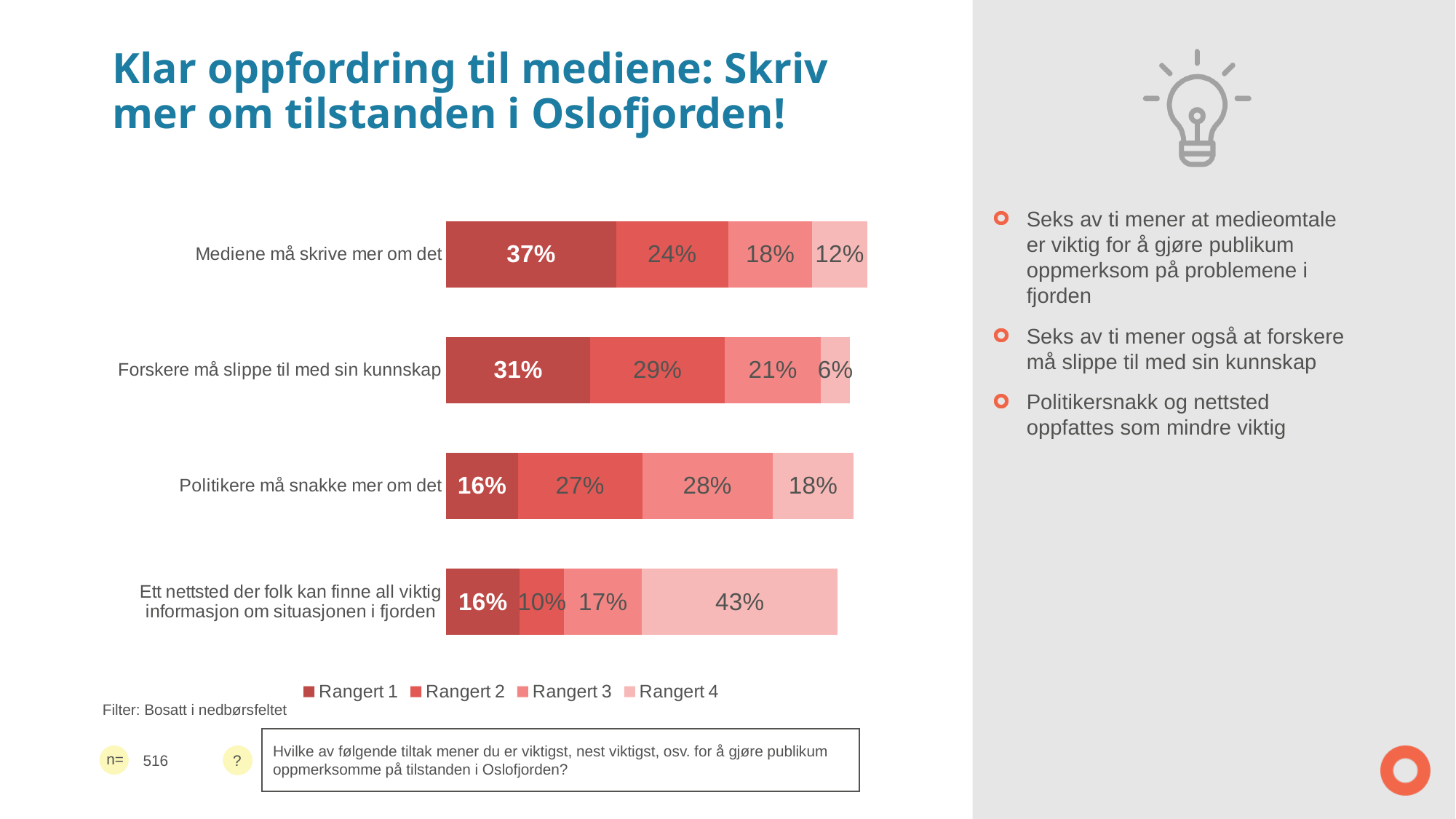
Which is larger: the Rangert 2 value for "Politikere må snakke mer om det" or the Rangert 2 value for "Ett nettsted der folk kan finne all viktig informasjon om situasjonen i fjorden"? Politikere må snakke mer om det What is the total of the printed values in the bar for "Mediene må skrive mer om det"? 91% How many series does the legend list? 4 How many categories are shown in the chart? 4 What kind of chart is shown on the slide? Stacked bar chart What is the Rangert 4 value for "Ett nettsted der folk kan finne all viktig informasjon om situasjonen i fjorden"? 43% What is the Rangert 3 value for "Politikere må snakke mer om det"? 28% What is the Rangert 1 value for "Mediene må skrive mer om det"? 37% What is the difference between the Rangert 1 values for "Mediene må skrive mer om det" and "Forskere må slippe til med sin kunnskap"? 6% What is the Rangert 2 value for "Forskere må slippe til med sin kunnskap"? 29% Which category has the highest Rangert 1 value? Mediene må skrive mer om det Which category has the lowest Rangert 4 value? Forskere må slippe til med sin kunnskap